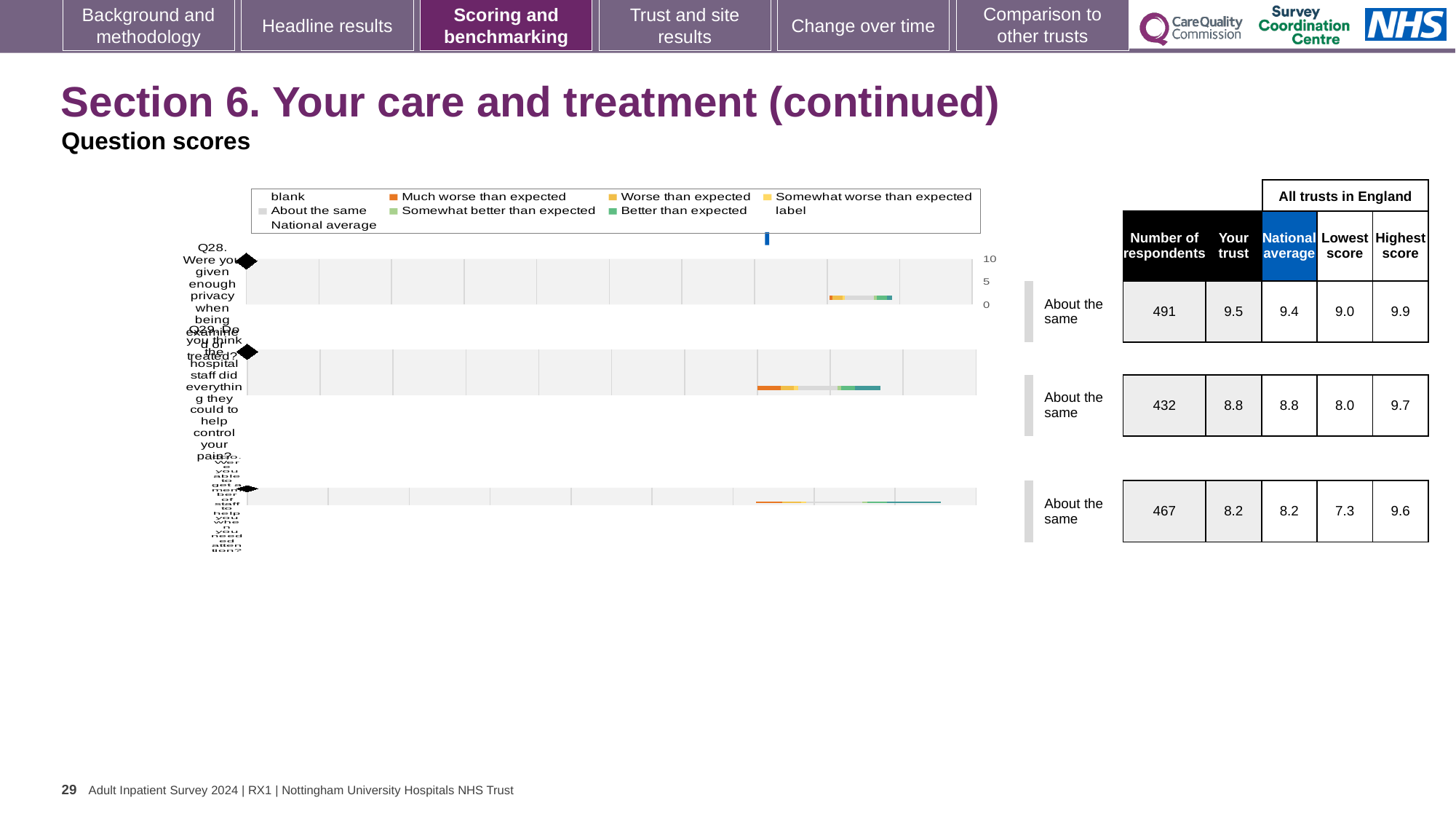
How many questions (rows) are plotted in the chart? 3 Which question has the lowest 'Your trust' score? Q30 What is the national average score for Q29 (staff did everything to help control pain)? 8.8 What is the lowest score across all trusts in England for Q30 (able to get a member of staff to help)? 7.3 Which question has the highest 'Your trust' score? Q28 What benchmark category is shown for Q29? About the same What is the 'Your trust' score for Q28 (privacy when being examined or treated)? 9.5 What is the difference between the 'Your trust' scores for Q28 and Q29? 0.7 How many respondents answered Q30? 467 What is the highest tick value shown on the chart's score axis? 10 For Q28, which is larger: the 'Your trust' score or the national average? Your trust What kind of chart is used to show the question scores? bar chart